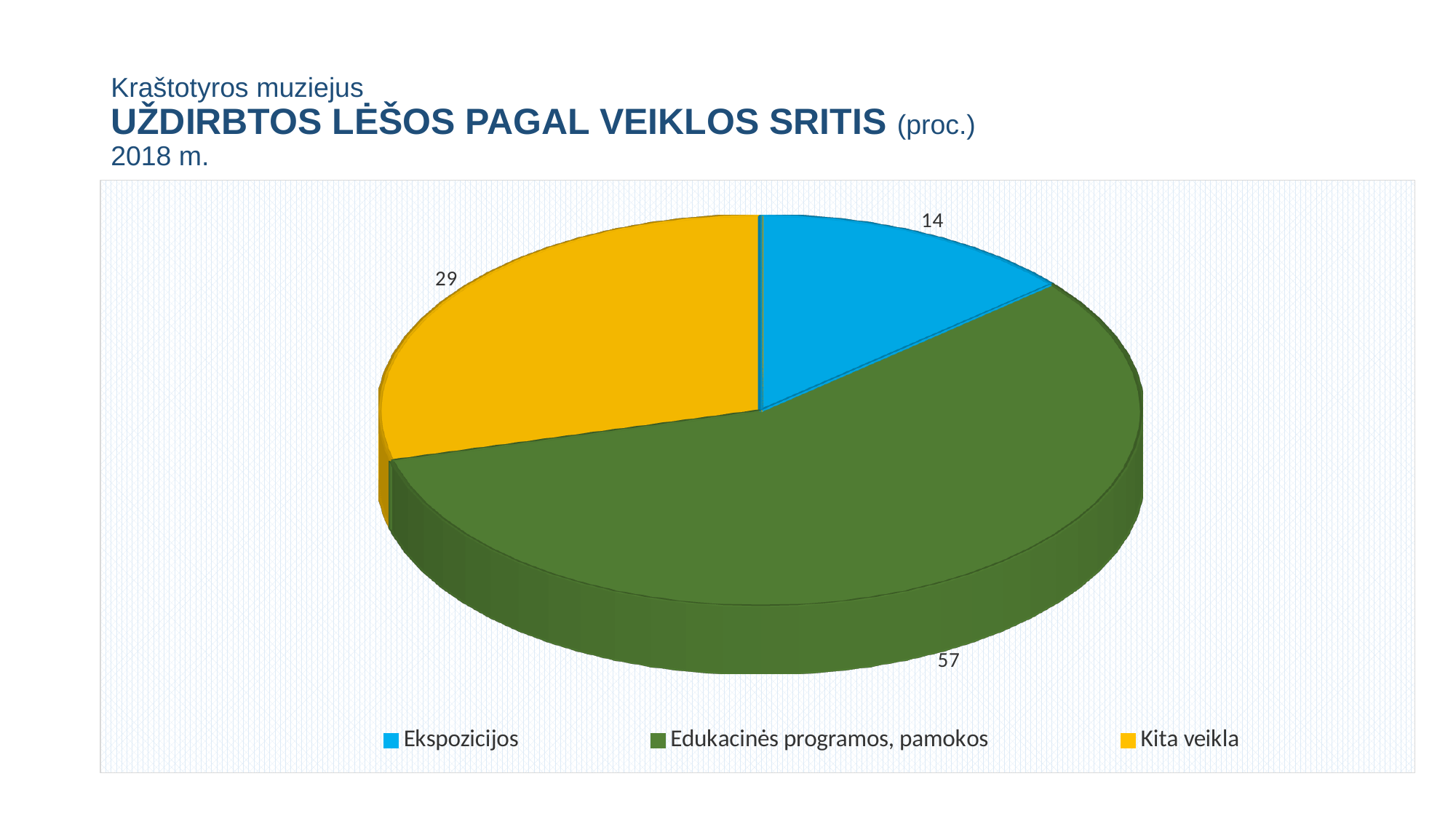
What is the difference between the values for Kita veikla and Ekspozicijos? 15 Which category has the largest slice? Edukacinės programos, pamokos Which category has the smallest slice? Ekspozicijos How many slices does the pie chart have? 3 What is the value for Kita veikla? 29 What kind of chart is shown on the slide? pie chart How many entries does the legend list? 3 Which is larger, the value for Kita veikla or the value for Ekspozicijos? Kita veikla What is the value for Ekspozicijos? 14 Which colour represents Kita veikla in the chart? yellow What is the value for Edukacinės programos, pamokos? 57 What is the difference between the values for Edukacinės programos, pamokos and Kita veikla? 28